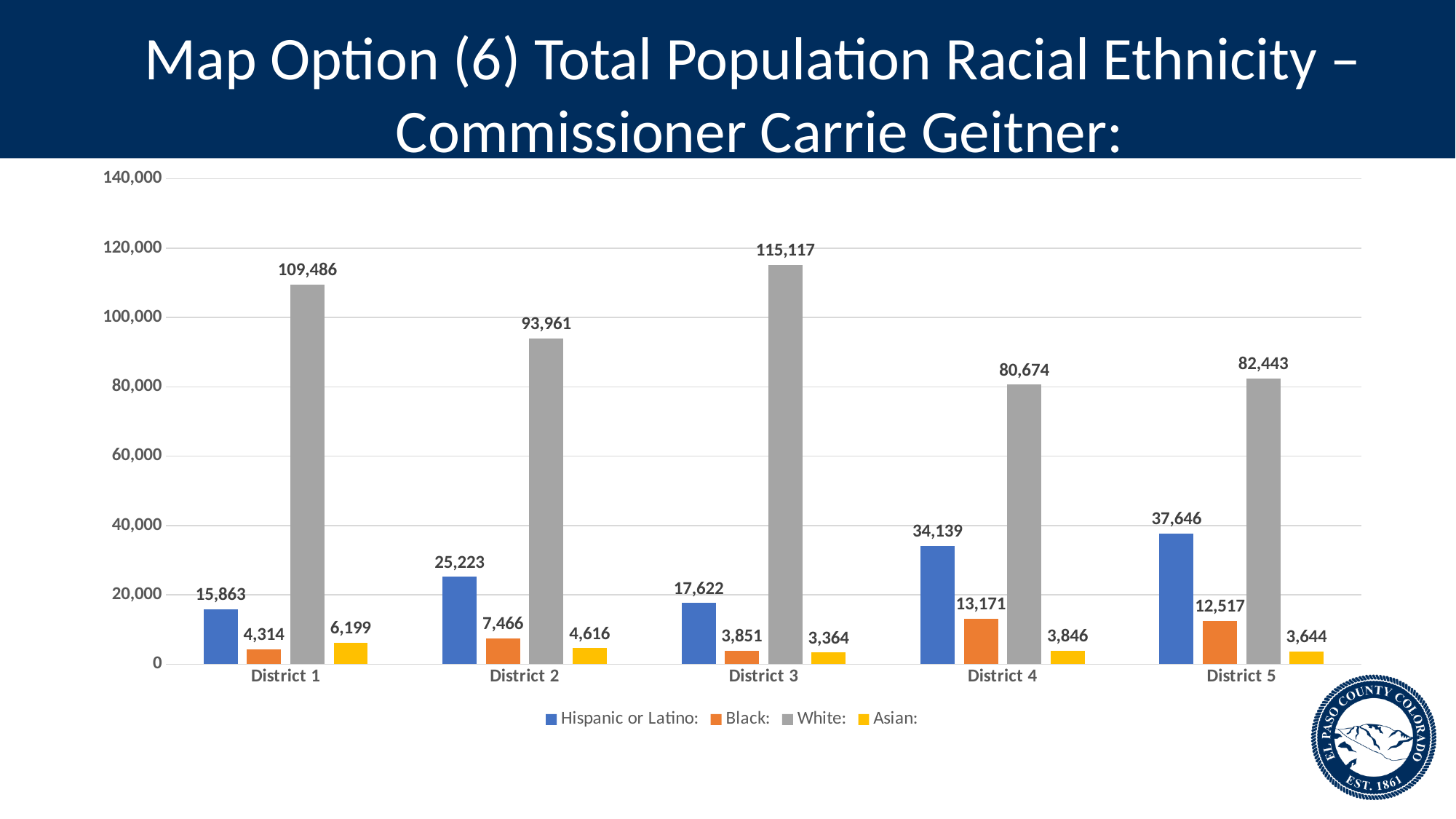
What is the Hispanic or Latino population value for District 5? 37,646 Which district has the lowest Hispanic or Latino population? District 1 What is the Black population value for District 4? 13,171 How many districts are shown on the x axis? 5 What is the Asian population value for District 1? 6,199 What is the White population value for District 3? 115,117 What kind of chart is shown on the slide? bar chart What is the difference between the White population in District 1 and District 2? 15,525 Which is larger, the Black population in District 4 or in District 5? District 4 How many series does the legend list? 4 Is the White population value for District 4 greater or less than 100,000? less Which district has the highest White population? District 3